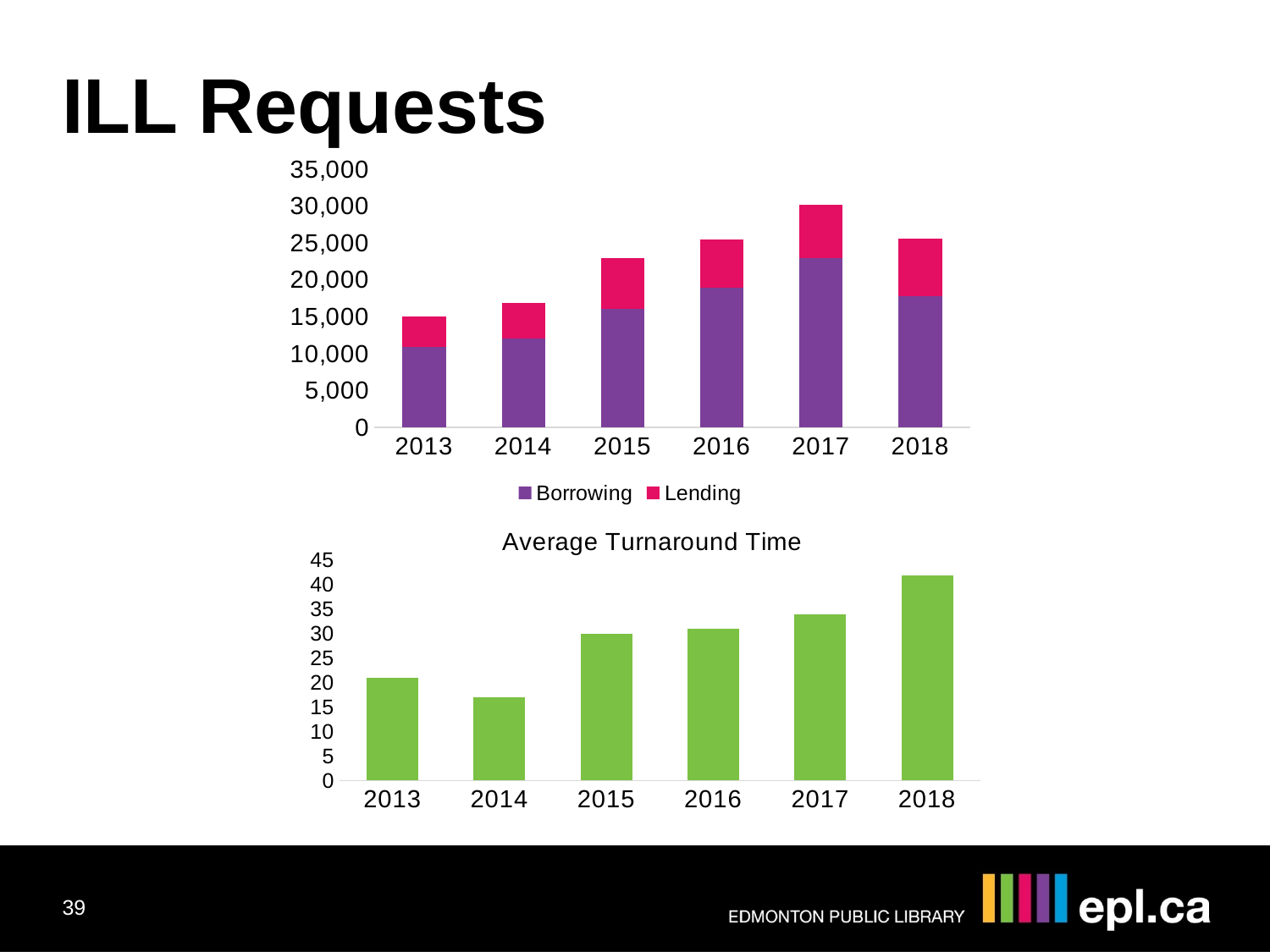
In the top chart, is the Borrowing value for 2013 greater or less than 15,000? less In the Average Turnaround Time chart, is the value for 2014 greater or less than 20? less In the Average Turnaround Time chart, which year has the lowest value? 2014 How many years are shown on the x axis of the Average Turnaround Time chart? 6 What are the two series named in the legend of the top chart? Borrowing and Lending In the top chart, which year has the tallest stacked bar? 2017 What kind of chart is the top chart on the slide? stacked bar chart What kind of chart is the Average Turnaround Time chart? bar chart In the top chart, which year has the shortest stacked bar? 2013 In the top chart, is the total stacked bar for 2017 greater or less than 25,000? greater How many series does the legend of the top chart list? 2 In the Average Turnaround Time chart, which year has the highest value? 2018